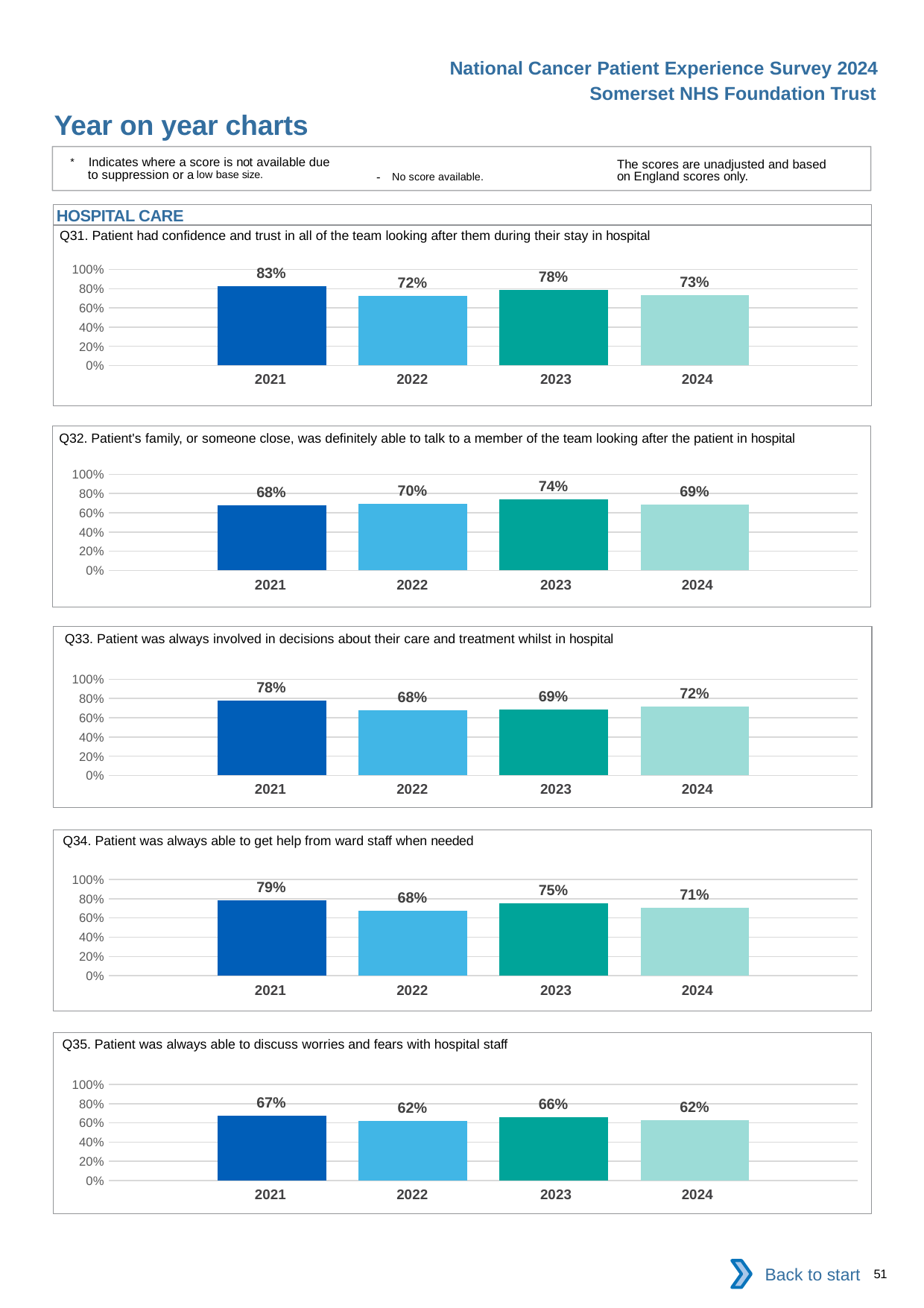
In the Q32 chart, which year has the highest value? 2023 In the Q34 chart, what is the difference between the 2023 and 2024 values? 4 percentage points In the Q31 chart, is the value for 2023 larger or smaller than the value for 2024? larger In the Q32 chart, is the value for 2021 greater or less than 80%? less In the Q31 chart, what is the value for 2021? 83% What kind of chart is the Q33 chart? bar chart How many charts are shown on the slide? 5 How many years are shown in the Q34 chart? 4 In the Q33 chart, what is the difference between the 2021 and 2022 values? 10 percentage points In the Q34 chart, which year has the lowest value? 2022 In the Q35 chart, what is the value for 2023? 66% In the Q35 chart, what is the value for 2024? 62%